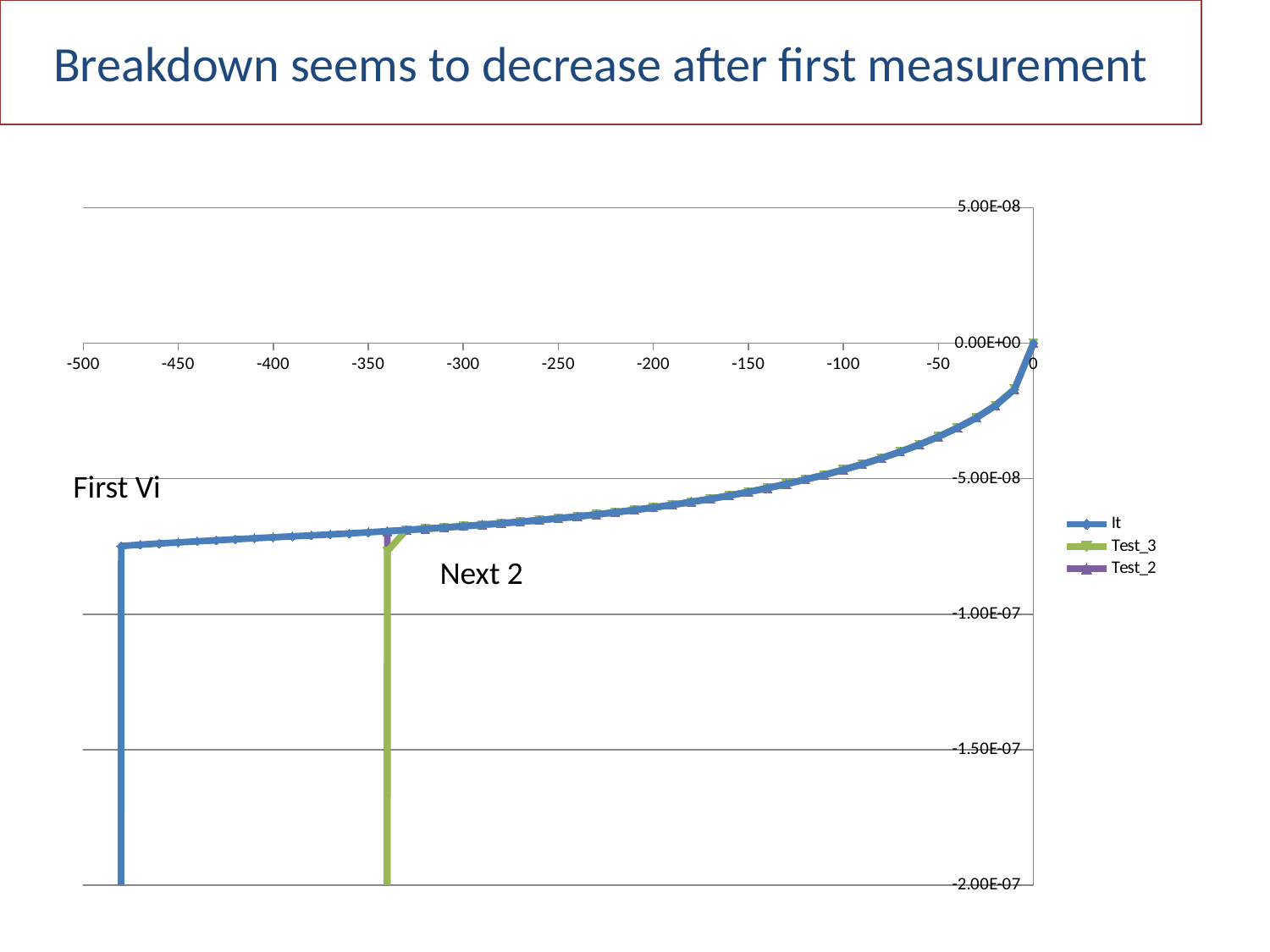
Do the values of the It series rise or fall as the x axis goes from -500 to 0? rise Is the value of the It series at x = -50 greater or less than -5.00E-08? greater Is the vertical drop of the Test_3 series located at an x value greater or less than -350? greater What kind of chart is shown on the slide? line chart What is the most negative value shown on the x axis? -500 What are the names of the series listed in the legend? It, Test_3, Test_2 Is the value of the It series at x = -450 greater or less than -1.00E-07? greater Which series shows its sharp vertical drop (breakdown) at the most negative x value? It What is the lowest value shown on the y axis? -2.00E-07 What colour is the line for the series It? blue How many series does the legend list? 3